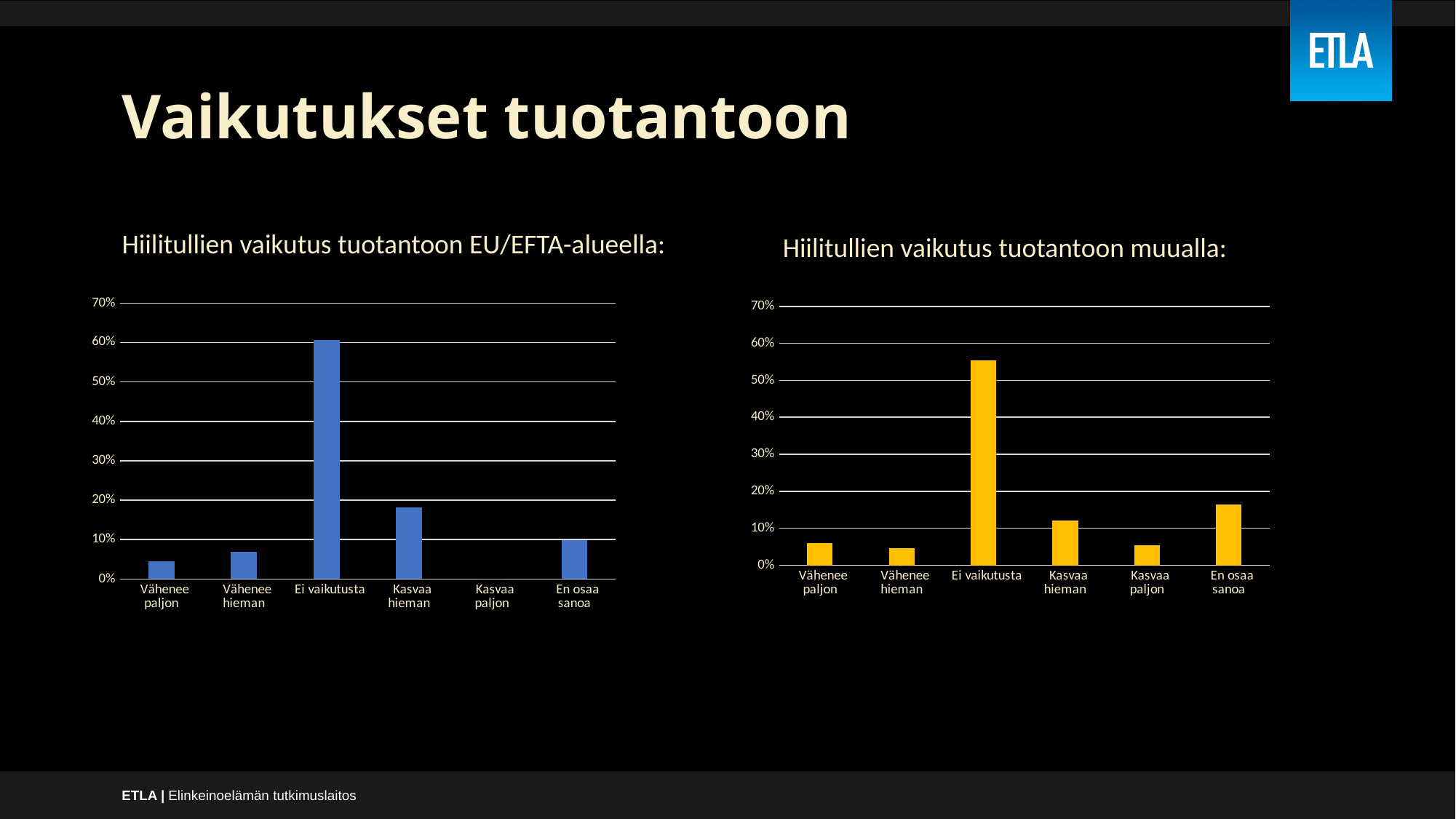
In the chart titled "Hiilitullien vaikutus tuotantoon muualla:", is the value for En osaa sanoa greater or less than 20%? less How many categories are shown on the x axis of the chart titled "Hiilitullien vaikutus tuotantoon EU/EFTA-alueella:"? 6 In the chart titled "Hiilitullien vaikutus tuotantoon EU/EFTA-alueella:", is the value for Ei vaikutusta greater or less than 50%? greater In the chart titled "Hiilitullien vaikutus tuotantoon EU/EFTA-alueella:", which is larger, Kasvaa hieman or En osaa sanoa? Kasvaa hieman In the chart titled "Hiilitullien vaikutus tuotantoon EU/EFTA-alueella:", is the value for Kasvaa hieman greater or less than 20%? less In the chart titled "Hiilitullien vaikutus tuotantoon muualla:", which is larger, En osaa sanoa or Kasvaa hieman? En osaa sanoa In the chart titled "Hiilitullien vaikutus tuotantoon muualla:", which category has the highest value? Ei vaikutusta In the chart titled "Hiilitullien vaikutus tuotantoon EU/EFTA-alueella:", which category has the highest value? Ei vaikutusta In the chart titled "Hiilitullien vaikutus tuotantoon EU/EFTA-alueella:", which category has the lowest value? Kasvaa paljon What colour are the bars in the chart titled "Hiilitullien vaikutus tuotantoon muualla:"? Yellow What kind of chart is the chart titled "Hiilitullien vaikutus tuotantoon EU/EFTA-alueella:"? Bar chart